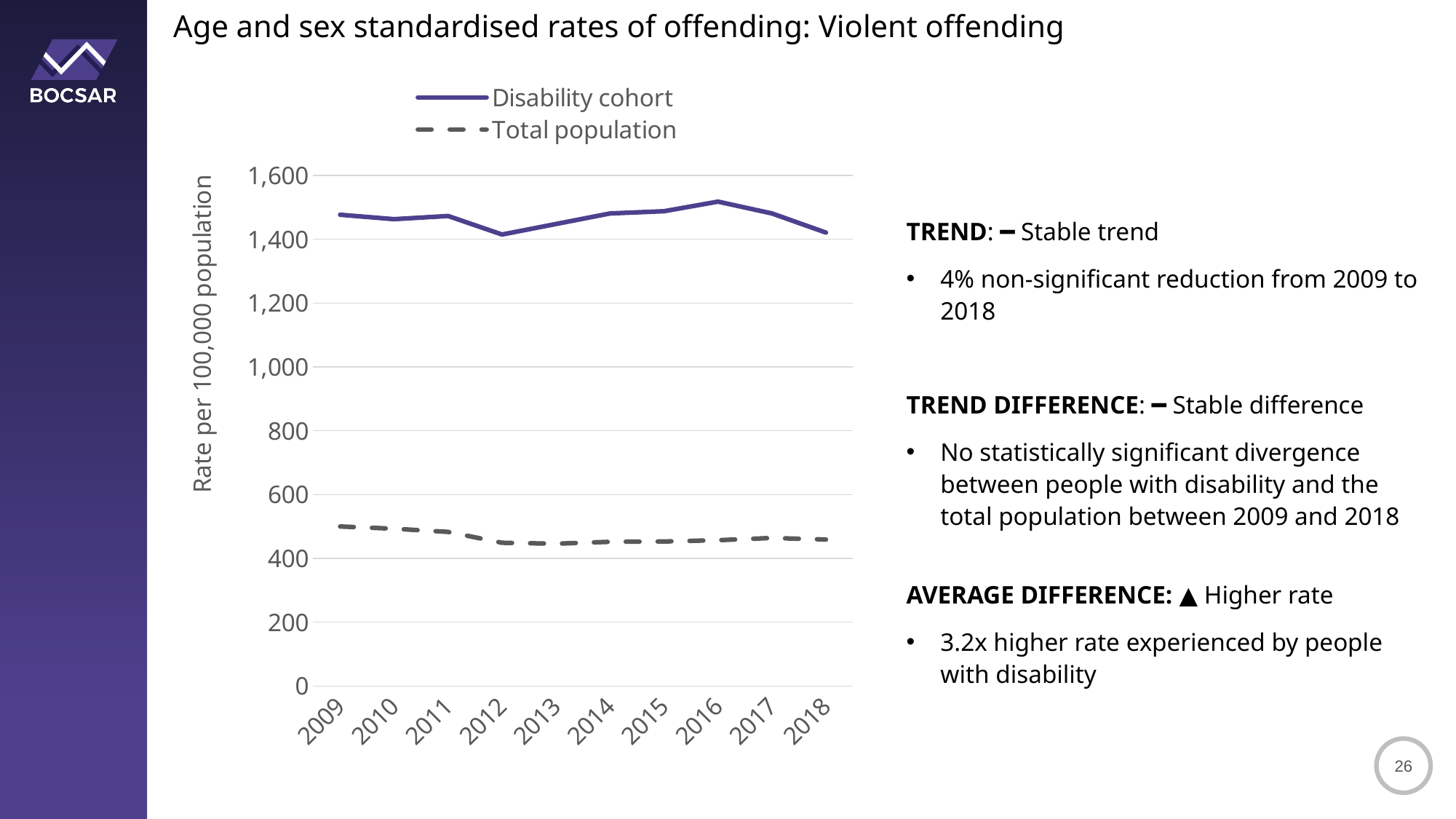
How many years are shown along the x axis of the chart? 10 Which is larger for the Disability cohort: the value in 2016 or the value in 2012? 2016 What kind of chart is shown on the slide? Line chart Does the Disability cohort series rise or fall between 2016 and 2018? Fall Is the value for the Total population in 2013 greater or less than 400? greater How many series does the chart legend list? 2 Which series in the chart is drawn with a dashed line? Total population In which year does the Total population series reach its highest value? 2009 Is the value for the Total population in 2009 greater or less than 600? less Is the value for the Disability cohort in 2016 greater or less than 1,400? greater In which year does the Disability cohort series reach its highest value? 2016 What is the label on the y axis of the chart? Rate per 100,000 population